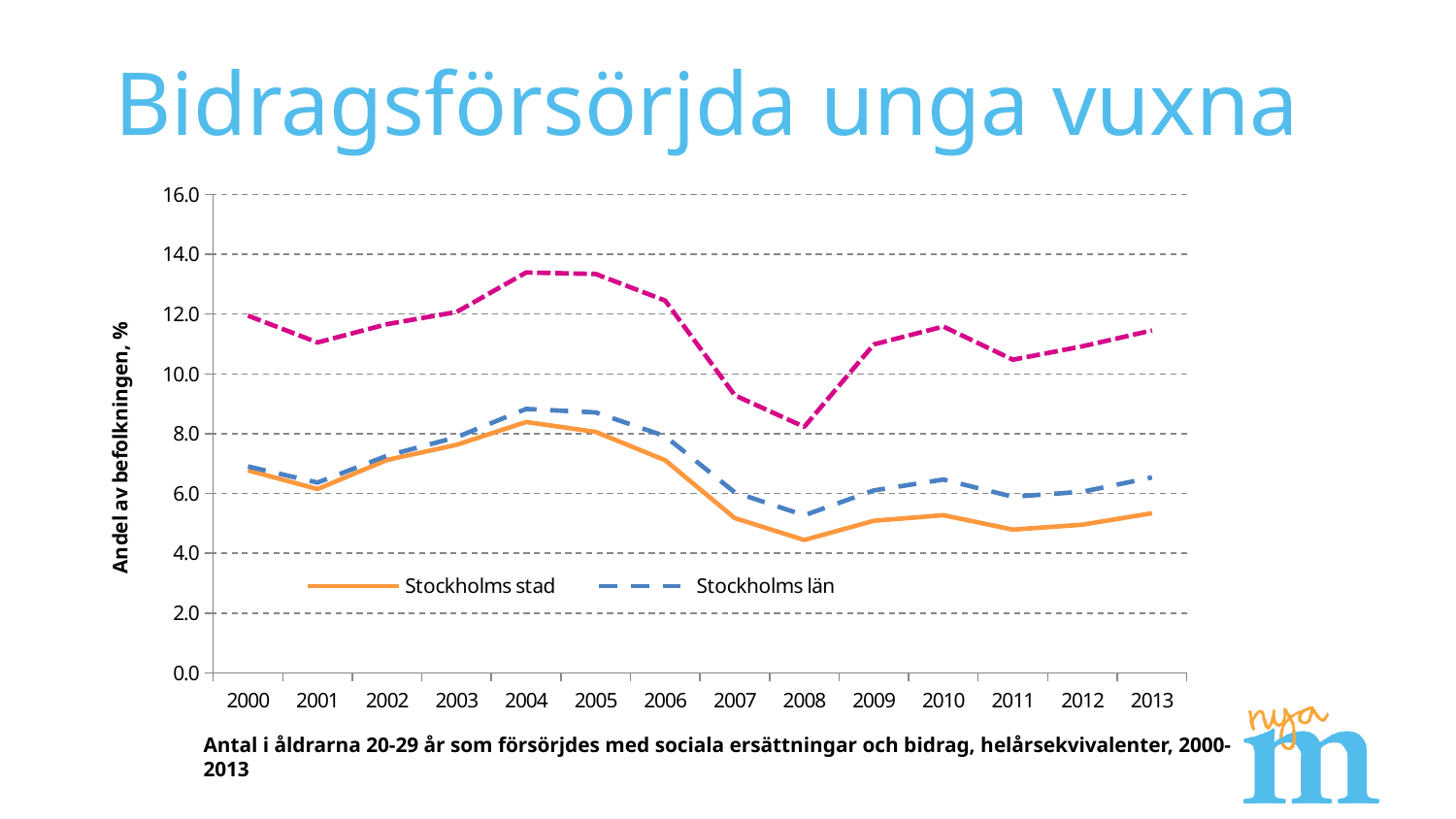
Does the Stockholms stad line rise or fall between 2004 and 2008? fall How many years are shown on the x axis? 14 Is the value for Stockholms län in 2004 greater or less than 8.0? greater Is the value for Stockholms stad in 2013 greater or less than 6.0? less What is the label on the y axis? Andel av befolkningen, % How many series does the legend list? 2 In which year is the Stockholms stad line at its highest? 2004 Is the value for Stockholms län in 2000 greater or less than 8.0? less In which year is the Stockholms stad line at its lowest? 2008 What kind of chart is shown on the slide? line chart In 2010, which is higher, Stockholms stad or Stockholms län? Stockholms län